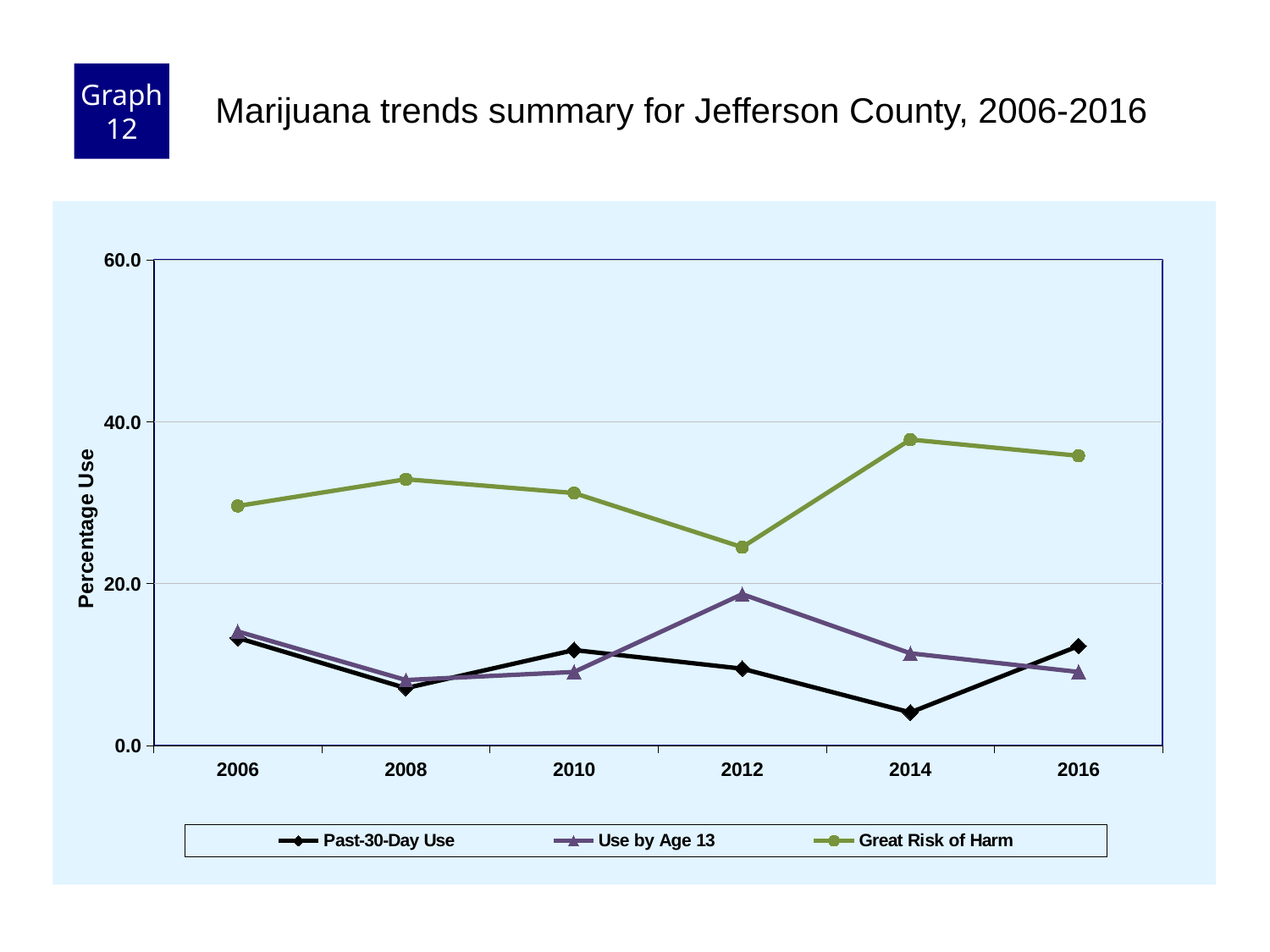
In which year is the Great Risk of Harm series at its highest? 2014 Does the Great Risk of Harm series rise or fall from 2012 to 2014? Rise How many years are plotted along the x axis? 6 In 2012, which is larger: Use by Age 13 or Past-30-Day Use? Use by Age 13 Is the value for Great Risk of Harm in 2012 greater or less than 20? greater In which year is the Past-30-Day Use series at its lowest? 2014 In which year is the Great Risk of Harm series at its lowest? 2012 What kind of chart is shown on the slide? Line chart In which year is the Use by Age 13 series at its highest? 2012 Is the value for Great Risk of Harm in 2014 greater or less than 40? less How many series does the legend list? 3 What is the label on the y axis? Percentage Use